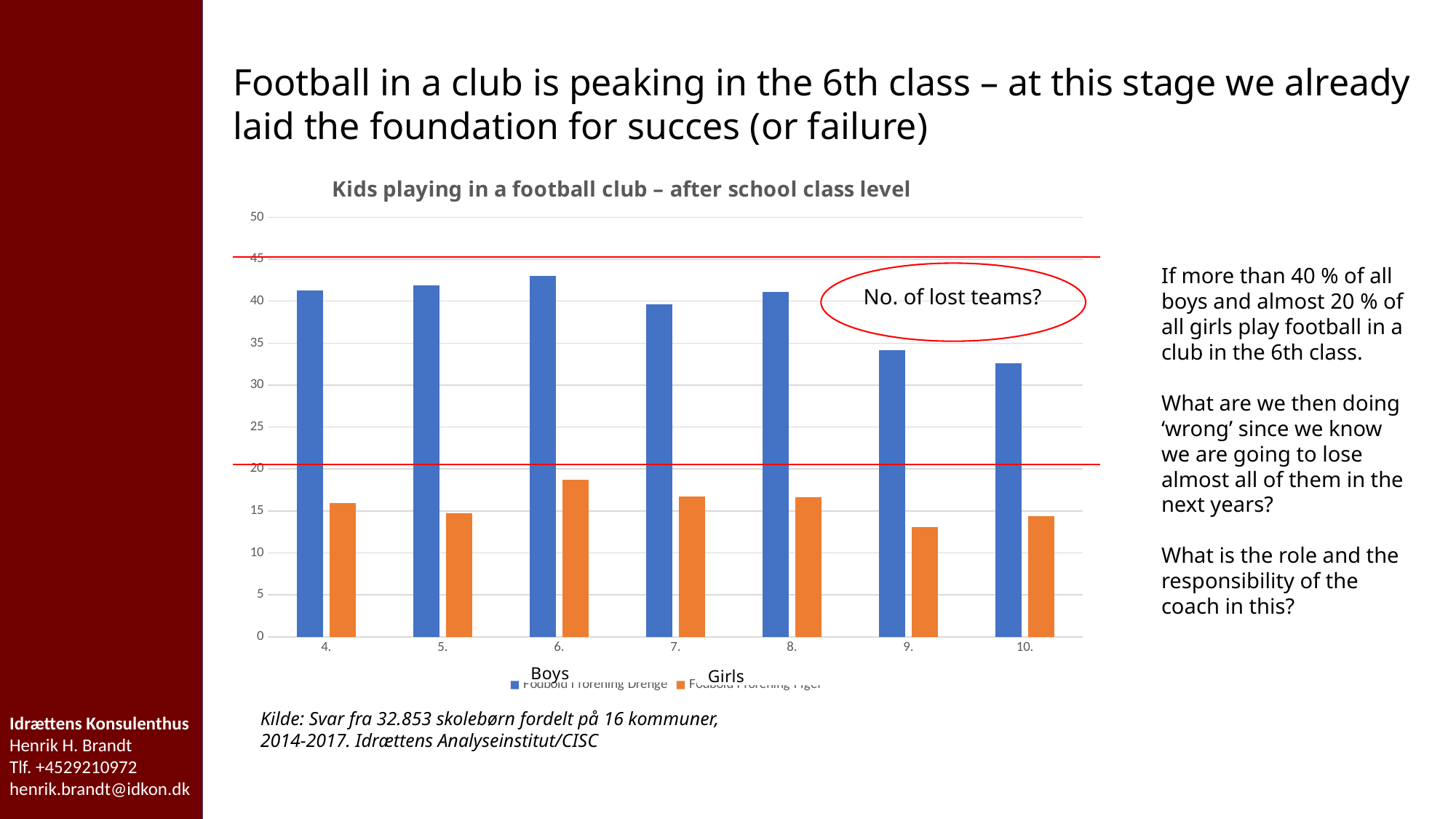
Which class level has the lowest value for Boys? 10. Which class level has the lowest value for Girls? 9. How many class levels are shown on the x axis of the chart? 7 What kind of chart is shown on the slide? bar chart Which class level has the highest value for Boys? 6. What is the title of the chart? Kids playing in a football club – after school class level Is the value for Girls in class 6. greater or less than 20? less How many series does the chart's legend list? 2 Which is larger: the value for Boys in class 4. or the value for Boys in class 9.? Boys in class 4. Is the value for Boys in class 6. greater or less than 40? greater Which class level has the highest value for Girls? 6. Do the values for Boys rise or fall from class 6. to class 10.? fall